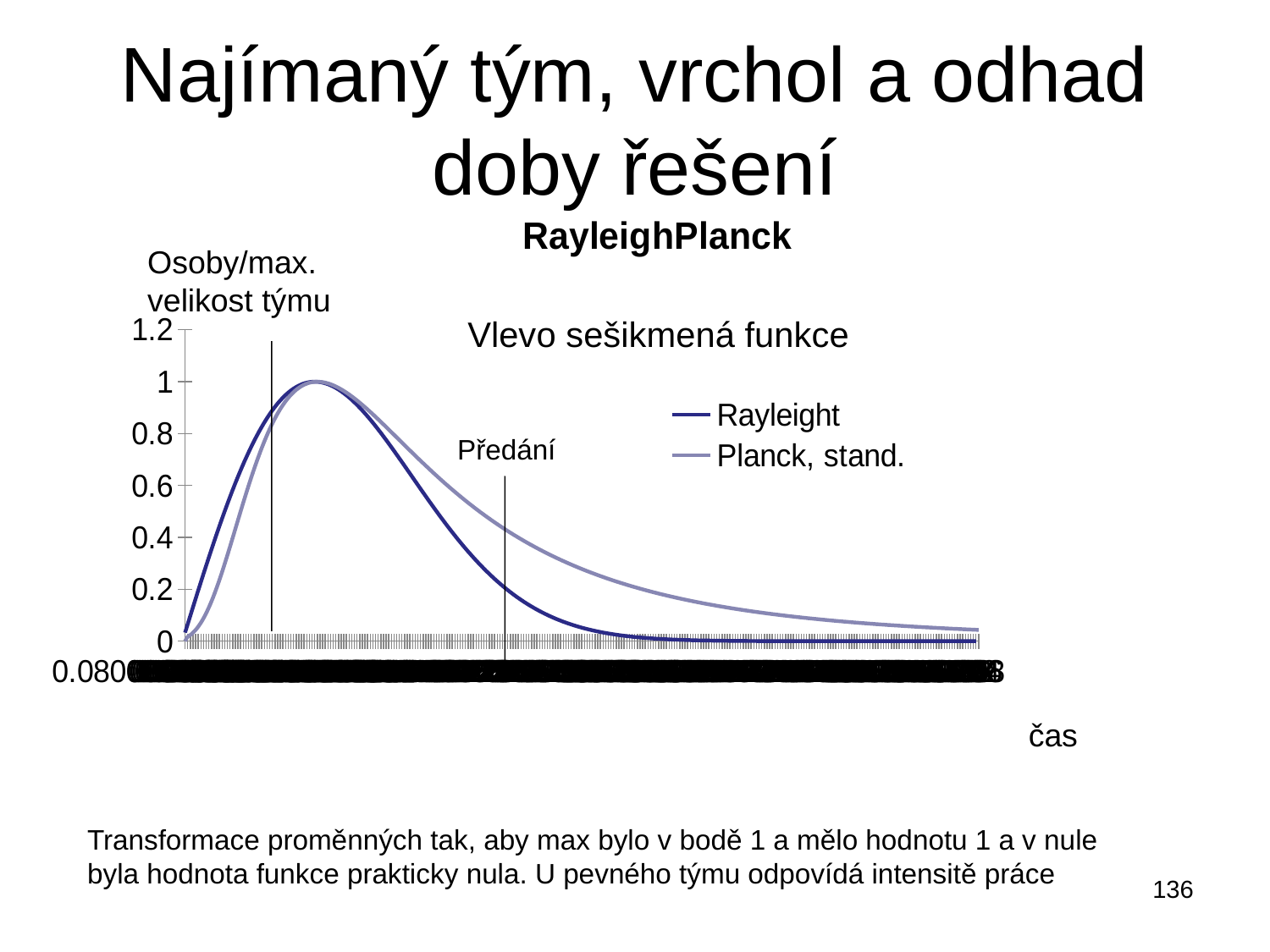
What are the two series named in the legend? Rayleight and Planck, stand. After reaching their peak, do the two curves rise or fall as the x axis increases? fall What is the highest tick value shown on the vertical axis? 1.2 How many series does the legend of the RayleighPlanck chart list? 2 At the vertical line labelled Předání, is the Planck, stand. value greater or less than 0.6? less At the right end of the x axis, which series has the higher value, Rayleight or Planck, stand.? Planck, stand. What kind of chart is shown on the slide? line chart What is the peak value reached by the Rayleight curve? 1 What is the peak value reached by the Planck, stand. curve? 1 At the vertical line labelled Předání, is the Rayleight value greater or less than 0.4? less At the vertical line labelled Předání, which series has the higher value, Rayleight or Planck, stand.? Planck, stand. What is the title of the chart? RayleighPlanck